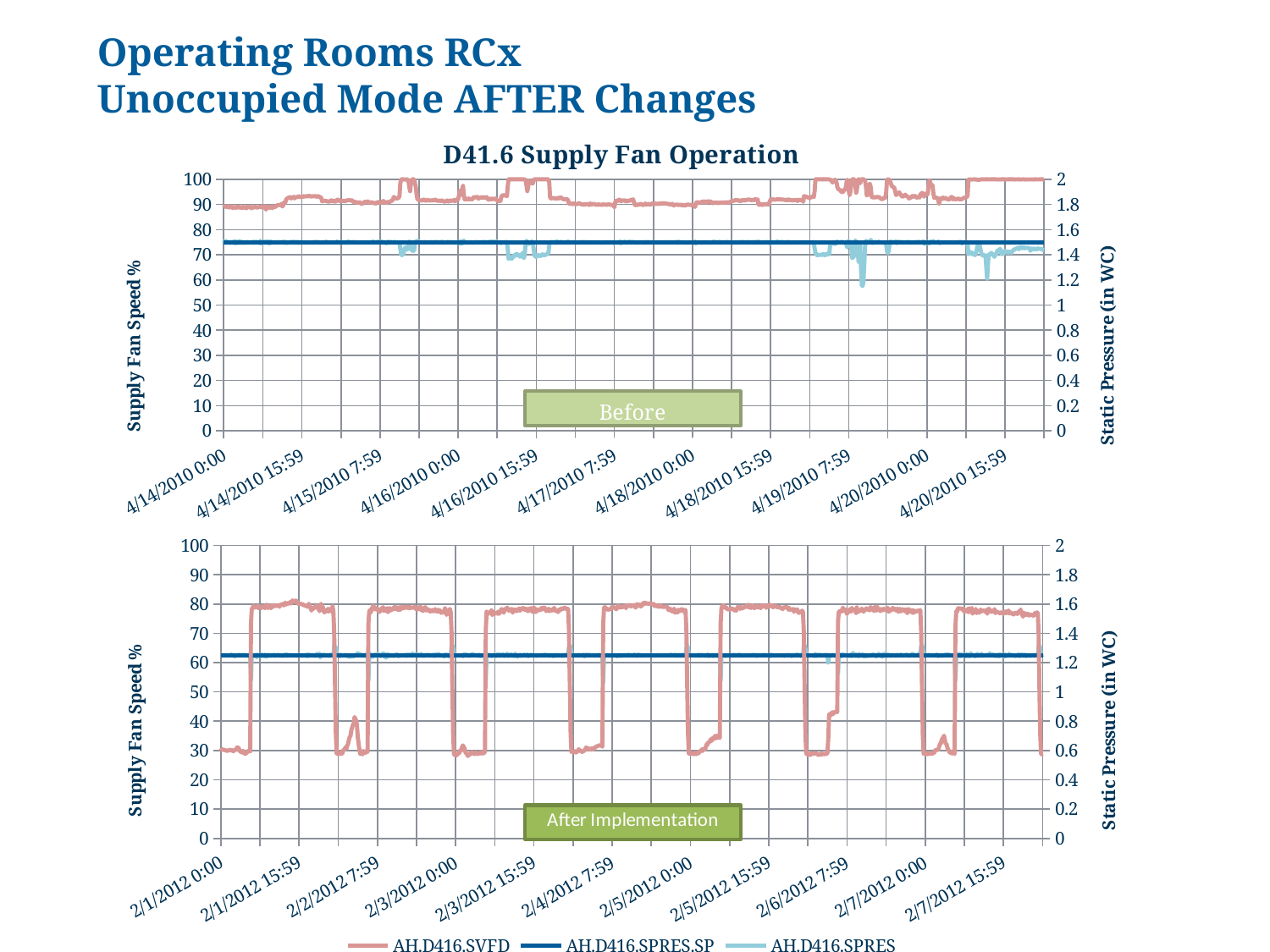
In the bottom chart (After Implementation), is the highest supply fan speed reached greater or less than 90? less In the top chart (Before), does the AH.D416.SPRES.SP line rise, fall, or stay flat across the x axis? stays flat What is the title of the top chart? D41.6 Supply Fan Operation What is the label of the right-hand vertical axis on the bottom chart? Static Pressure (in WC) How many date labels are shown on the x axis of the bottom chart? 11 In the bottom chart (After Implementation), is the supply fan speed at 2/1/2012 0:00 greater or less than 50? less What is the maximum value shown on the right vertical axis of the bottom chart? 2 In the bottom chart (After Implementation), is the AH.D416.SPRES.SP line greater or less than 1.4 on the right axis? less How many series does the legend at the bottom of the slide list? 3 What kind of chart is the top chart? line chart What is the maximum value shown on the left vertical axis of the top chart? 100